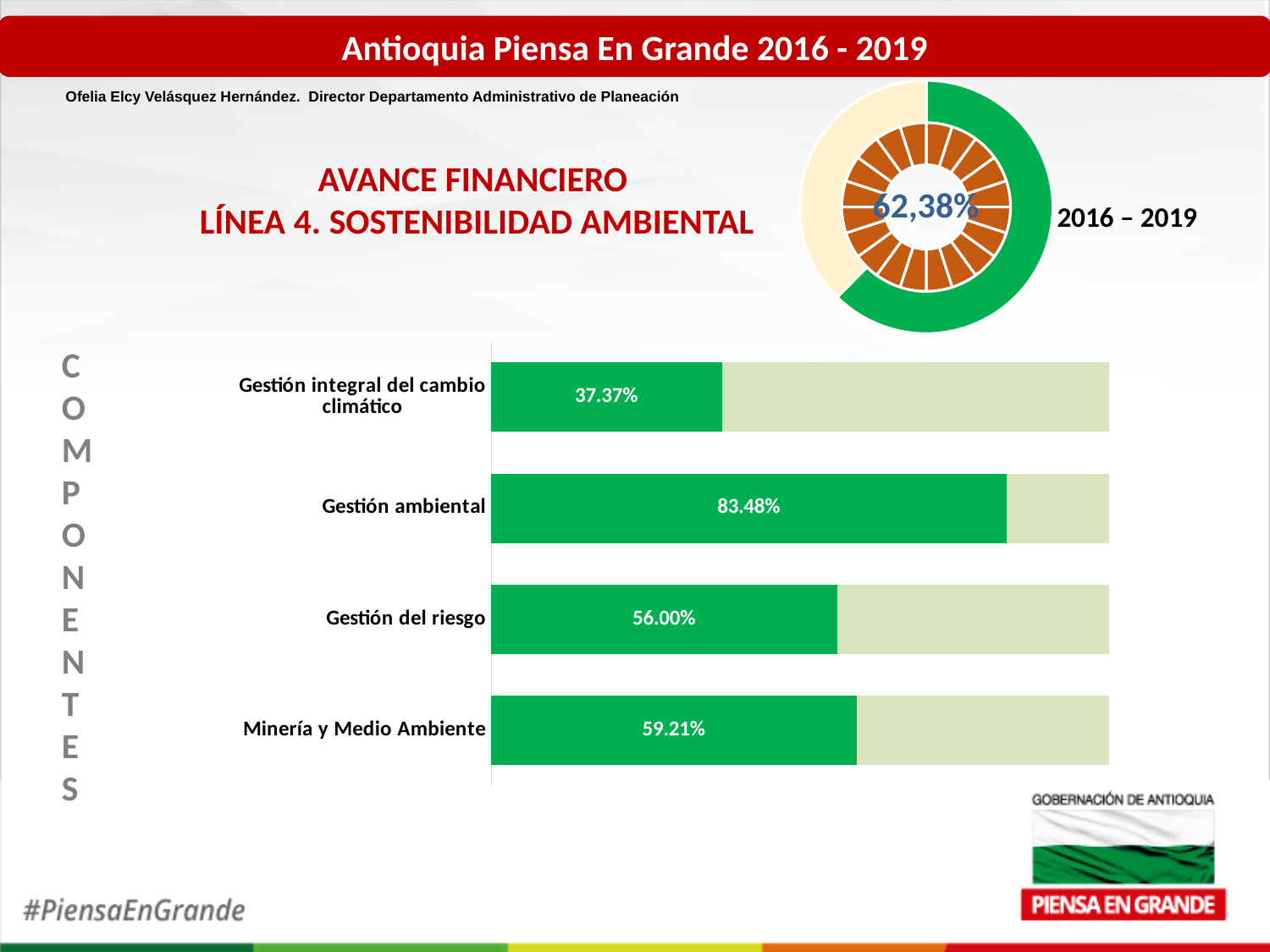
In the bar chart of components, what is the difference between Gestión ambiental and Gestión del riesgo? 27.48% In the bar chart of components, which component has the highest value? Gestión ambiental In the donut chart at the top right, what is the financial progress value shown for 2016 – 2019? 62,38% In the bar chart of components, what is the value for Gestión del riesgo? 56.00% In the bar chart of components, what is the value for Gestión ambiental? 83.48% What kind of chart is used to show the components? Bar chart What kind of chart is shown at the top right of the slide? Donut chart In the bar chart of components, which is larger: Minería y Medio Ambiente or Gestión del riesgo? Minería y Medio Ambiente In the bar chart of components, what is the value for Gestión integral del cambio climático? 37.37% How many components are shown in the bar chart? 4 In the bar chart of components, which component has the lowest value? Gestión integral del cambio climático In the bar chart of components, what is the value for Minería y Medio Ambiente? 59.21%